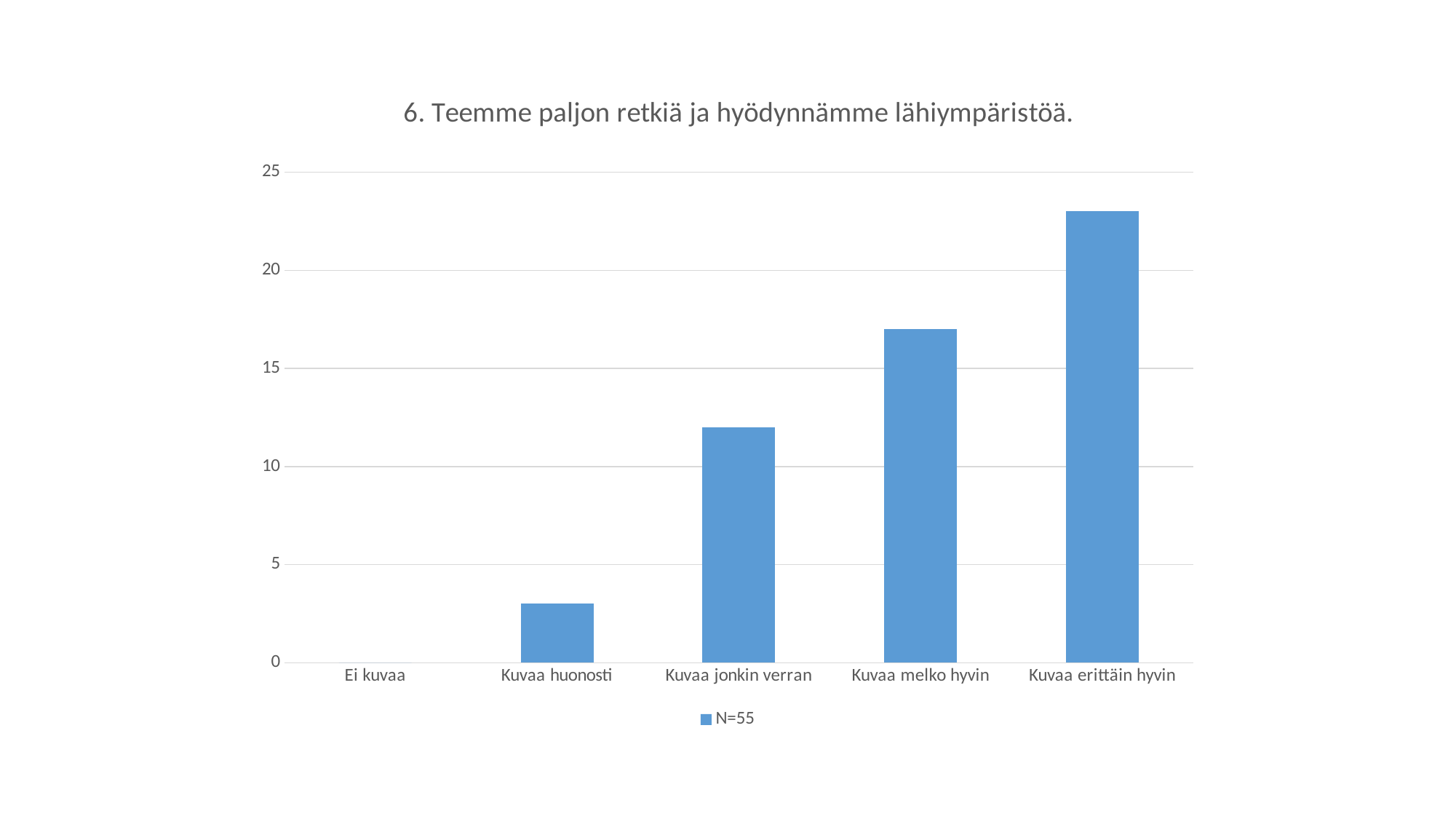
Is the value for Kuvaa erittäin hyvin greater or less than 20? greater What kind of chart is shown on the slide? bar chart Is the value for Kuvaa melko hyvin greater or less than 15? greater What is the title of the chart? 6. Teemme paljon retkiä ja hyödynnämme lähiympäristöä. Do the values rise or fall from left to right along the x axis? rise Which category has the highest value? Kuvaa erittäin hyvin How many categories are shown on the x axis? 5 Is the value for Kuvaa huonosti greater or less than 5? less Which category has the lowest value? Ei kuvaa How many series does the legend list? 1 What is the value for Ei kuvaa? 0 What is the legend entry for the series? N=55